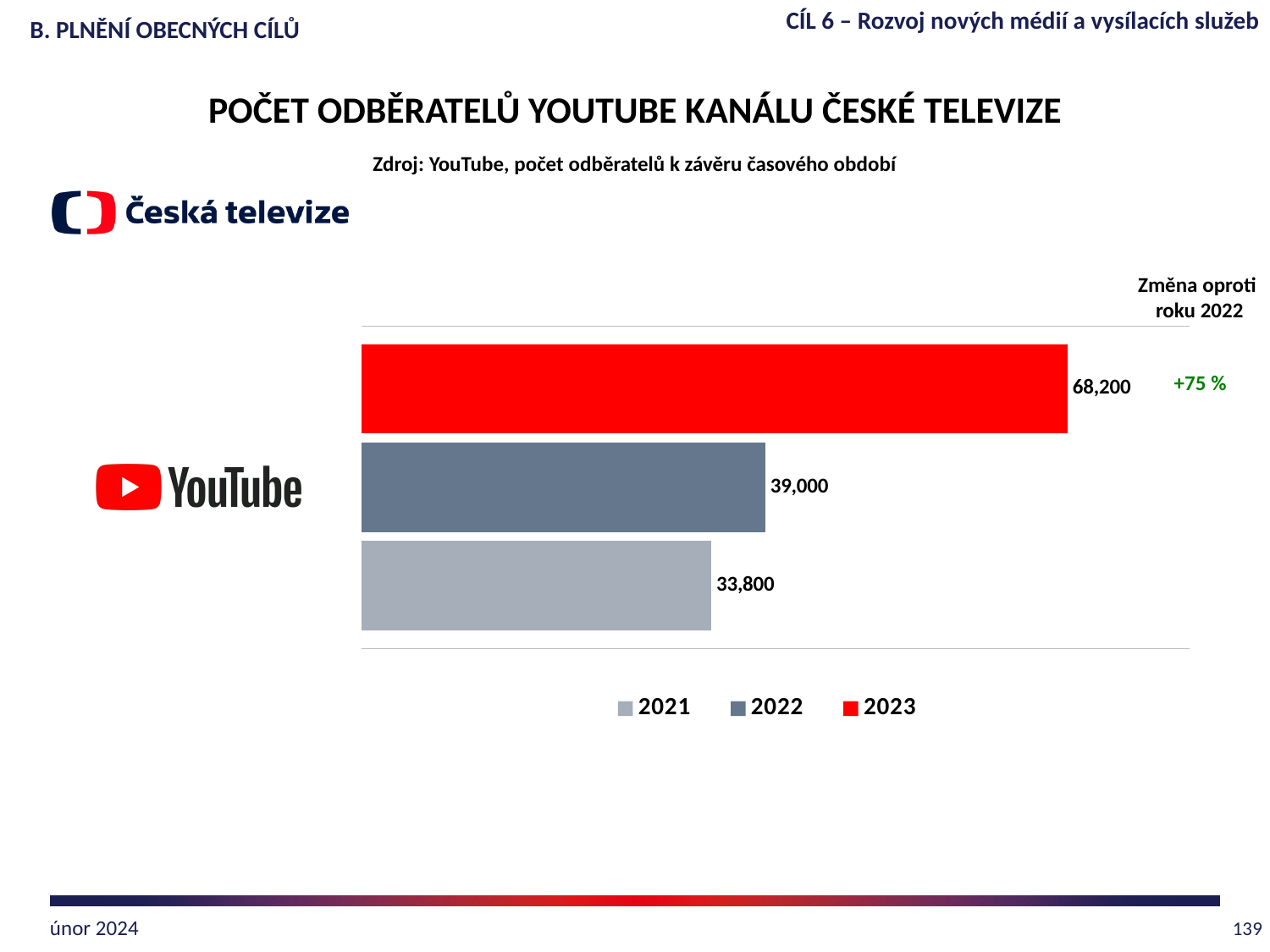
What kind of chart is shown on the slide? bar chart What is the number of YouTube subscribers shown for 2022? 39,000 Which year has the highest number of subscribers? 2023 What is the difference in subscribers between 2022 and 2021? 5,200 Which year has the lowest number of subscribers? 2021 Do the subscriber numbers rise or fall from 2021 to 2023? rise What is the number of YouTube subscribers shown for 2021? 33,800 What percentage change compared to 2022 is shown next to the 2023 bar? +75 % What is the number of YouTube subscribers shown for 2023? 68,200 What is the difference in subscribers between 2023 and 2022? 29,200 How many years (series) does the legend list? 3 Which year has more subscribers, 2021 or 2022? 2022